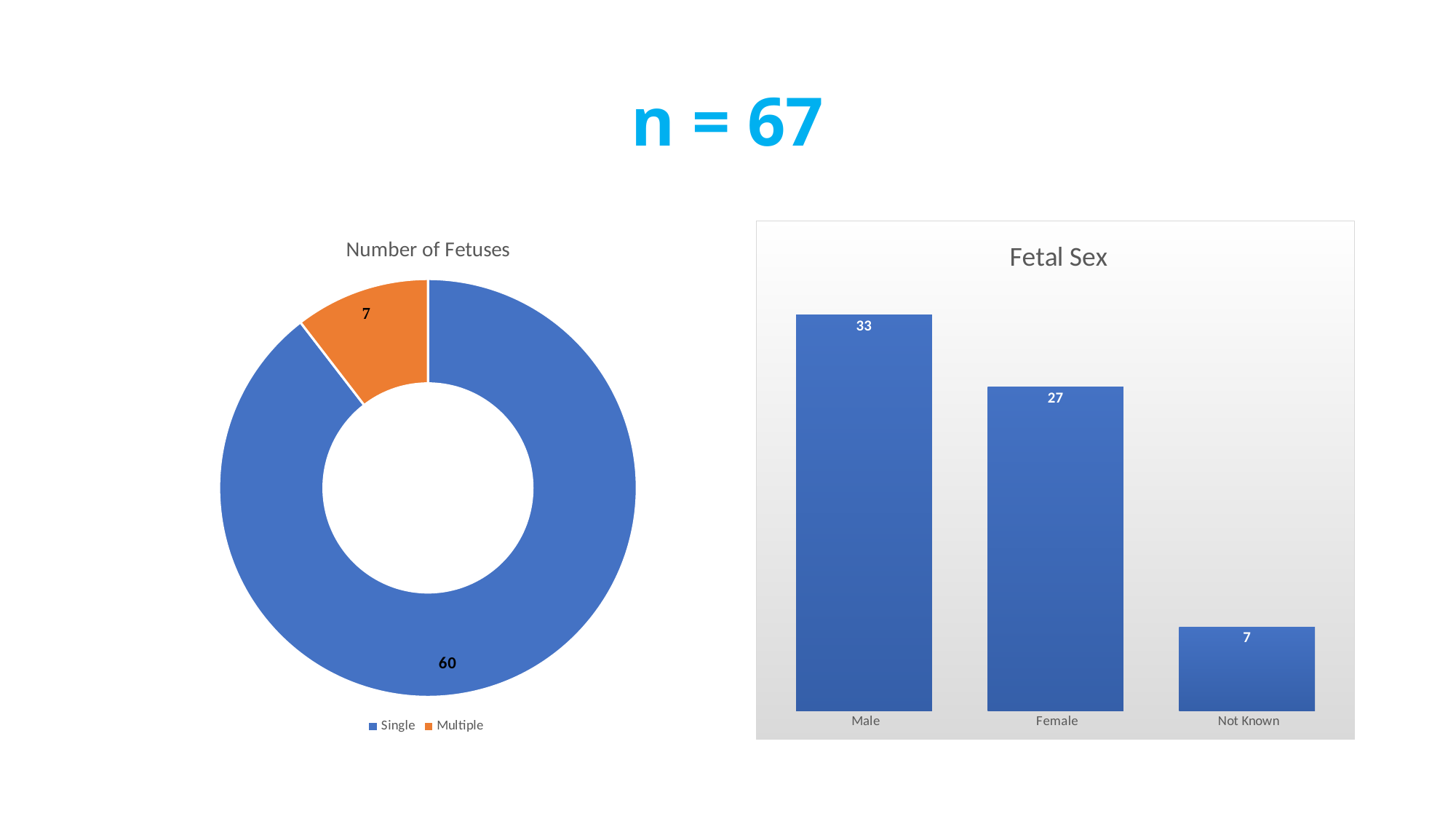
In the 'Fetal Sex' chart, what is the value for Male? 33 In the 'Number of Fetuses' chart, which category is larger, Single or Multiple? Single In the 'Number of Fetuses' chart, what kind of chart is shown? Doughnut chart In the 'Number of Fetuses' chart, what is the value for Single? 60 In the 'Number of Fetuses' chart, what is the difference between Single and Multiple? 53 In the 'Fetal Sex' chart, what is the difference between Male and Female? 6 In the 'Fetal Sex' chart, what is the value for Not Known? 7 In the 'Fetal Sex' chart, what is the value for Female? 27 In the 'Number of Fetuses' chart, what is the value for Multiple? 7 In the 'Fetal Sex' chart, which category has the highest value? Male In the 'Number of Fetuses' chart, how many categories does the legend list? 2 In the 'Fetal Sex' chart, what kind of chart is shown? Bar chart